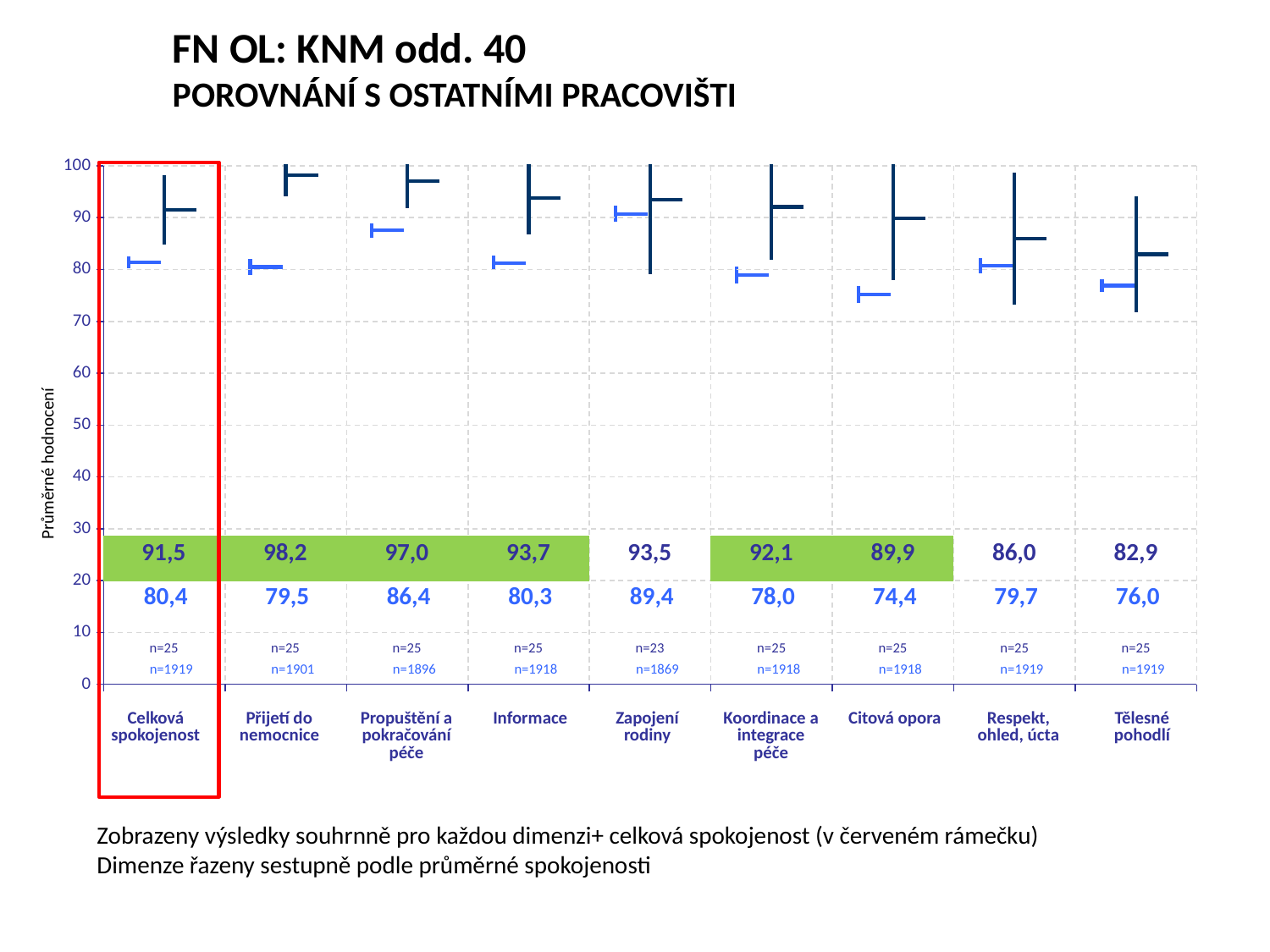
How many categories are shown on the x axis of the chart? 9 Which category has the lowest dark blue (upper row) value? Tělesné pohodlí Is the light blue marker for Citová opora greater or less than 80? less What is the difference between the dark blue and light blue values for Citová opora? 15,5 What is the label of the vertical axis of the chart? Průměrné hodnocení What is the light blue (lower row) value for Zapojení rodiny? 89,4 What is the difference between the dark blue and light blue values for Celková spokojenost? 11,1 What is the first n value (sample size) shown for Zapojení rodiny? n=23 Which has the larger light blue (lower row) value: Propuštění a pokračování péče or Informace? Propuštění a pokračování péče What is the dark blue (upper row) value for Přijetí do nemocnice? 98,2 Which category has the highest dark blue (upper row) value? Přijetí do nemocnice Which category has the lowest light blue (lower row) value? Citová opora